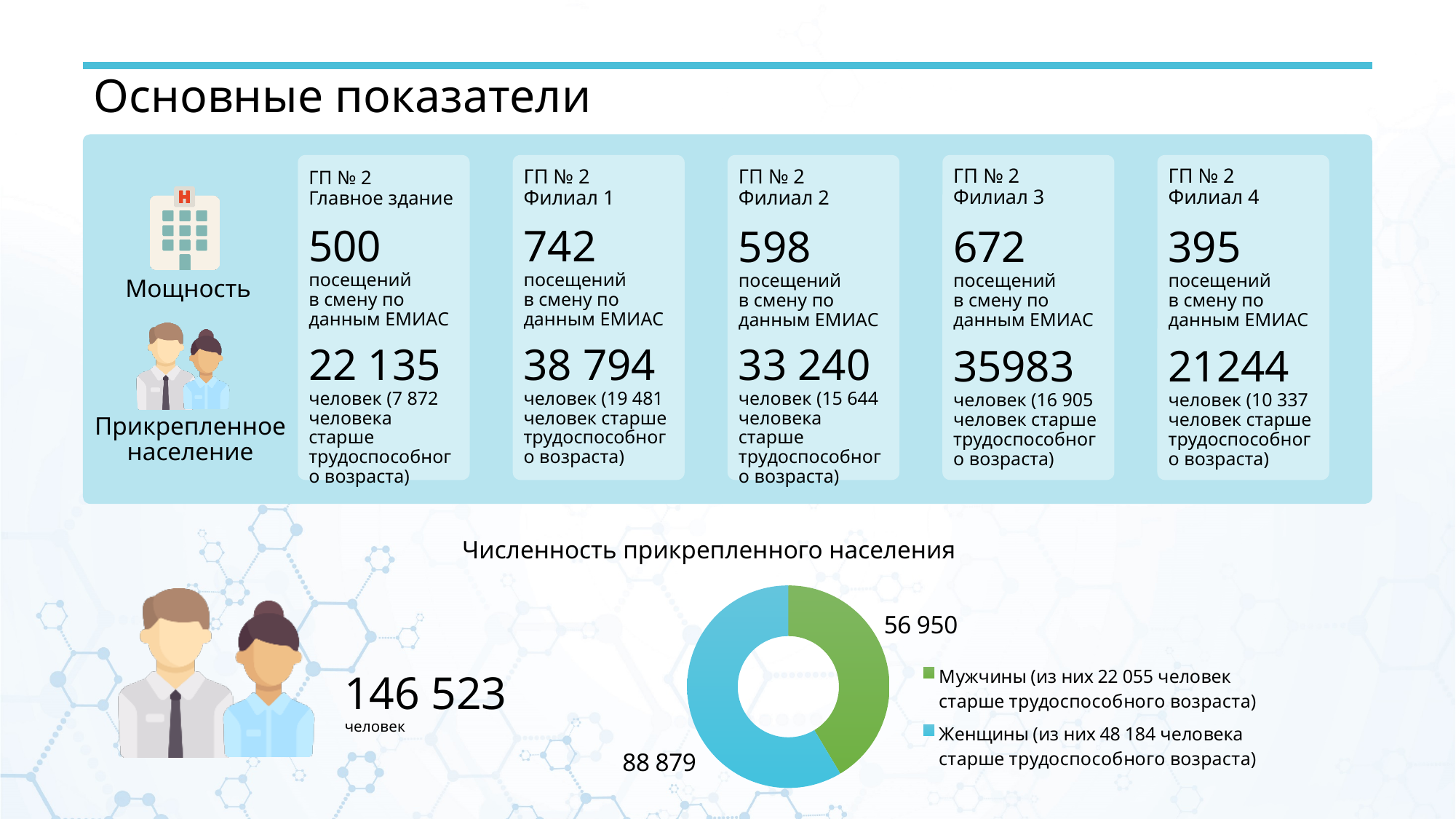
Which category has the largest slice in the doughnut chart? Женщины How many entries does the legend of the doughnut chart list? 2 What is the value for Мужчины in the doughnut chart? 56 950 What colour is the Мужчины slice in the doughnut chart? Green Which category has the smallest slice in the doughnut chart? Мужчины According to the legend of the doughnut chart, how many women are older than working age? 48 184 What is the value for Женщины in the doughnut chart? 88 879 How many slices does the doughnut chart have? 2 What is the title of the doughnut chart? Численность прикрепленного населения What is the difference between the Женщины and Мужчины values in the doughnut chart? 31 929 Which is larger in the doughnut chart, the value for Мужчины or for Женщины? Женщины What kind of chart is shown under the title "Численность прикрепленного населения"? Doughnut (pie) chart